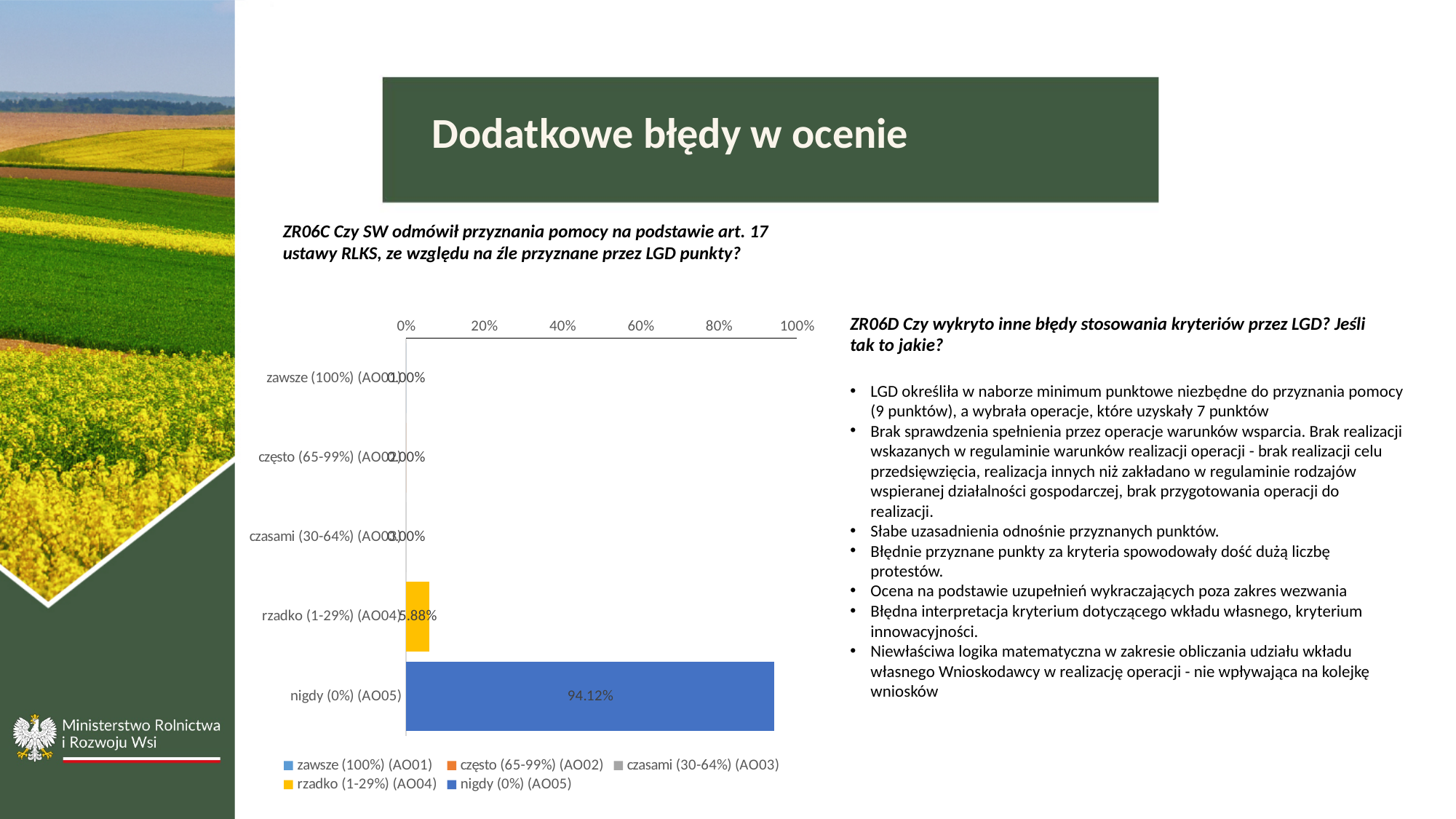
What is the value for rzadko (1-29%) (AO04)? 5.88% Which is larger, the value for nigdy (0%) (AO05) or the value for rzadko (1-29%) (AO04)? nigdy (0%) (AO05) Which category has the highest value? nigdy (0%) (AO05) What is the difference between the values for nigdy (0%) (AO05) and rzadko (1-29%) (AO04)? 88.24% Is the value for rzadko (1-29%) (AO04) greater or less than 20%? less Is the value for nigdy (0%) (AO05) greater or less than 80%? greater What colour is the bar for nigdy (0%) (AO05)? blue What is the value for nigdy (0%) (AO05)? 94.12% How many categories are shown on the chart? 5 How many entries does the legend list? 5 What kind of chart is shown on the slide? bar chart What colour is the bar for rzadko (1-29%) (AO04)? yellow